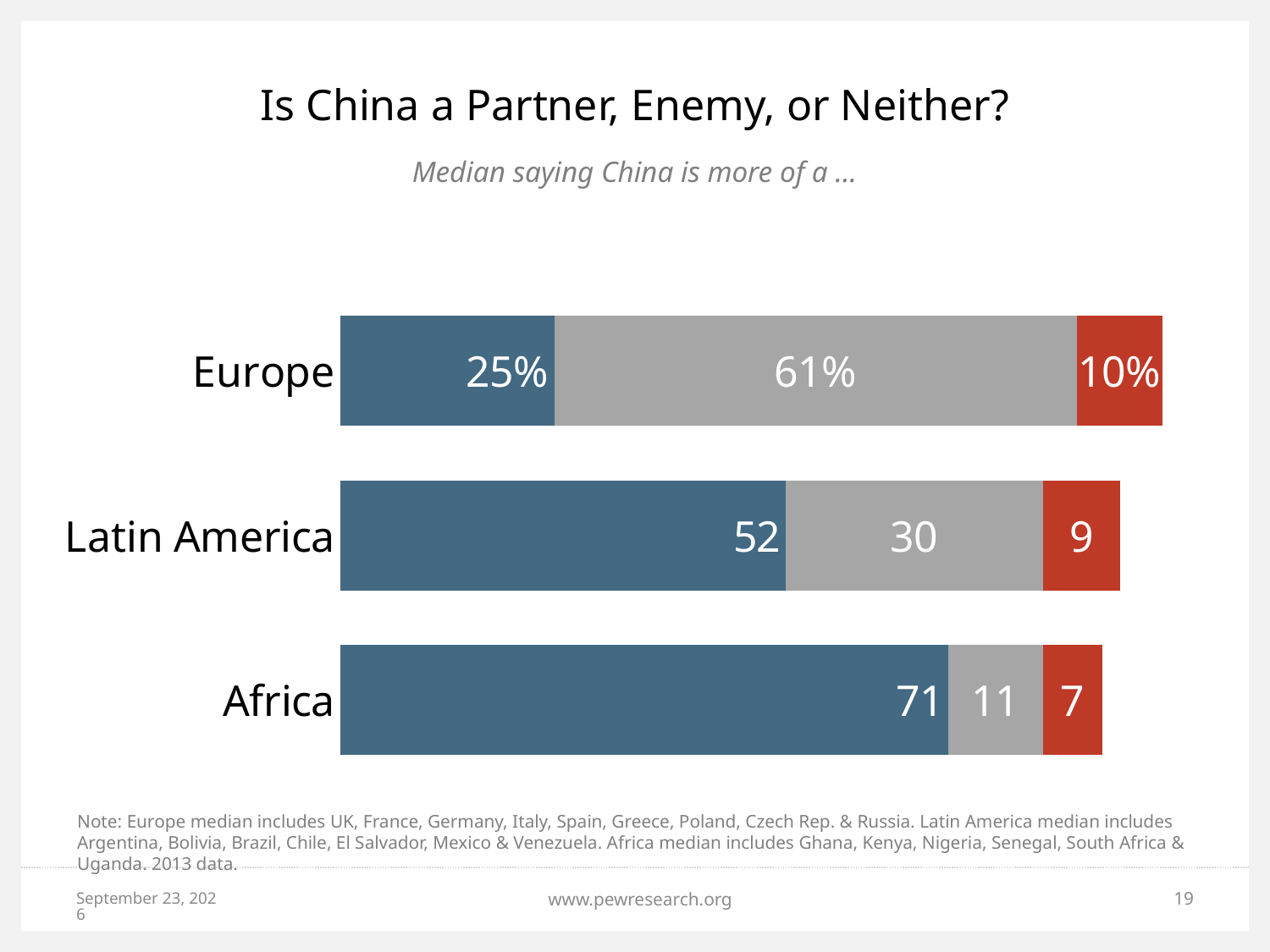
What is the value of the blue segment for Europe? 25% What is the total of the three segments for Latin America? 91 Which region has the smallest gray segment? Africa What is the total of the three segments for Europe? 96% What is the value of the gray segment for Latin America? 30 What is the value of the red segment for Africa? 7 What is the difference between the blue segment for Africa and the blue segment for Latin America? 19 How many regions are shown in the chart? 3 Which region has the largest blue segment? Africa What is the title of the chart? Is China a Partner, Enemy, or Neither? Which is larger: the gray segment for Europe or the gray segment for Latin America? Europe What kind of chart is shown on the slide? Stacked bar chart